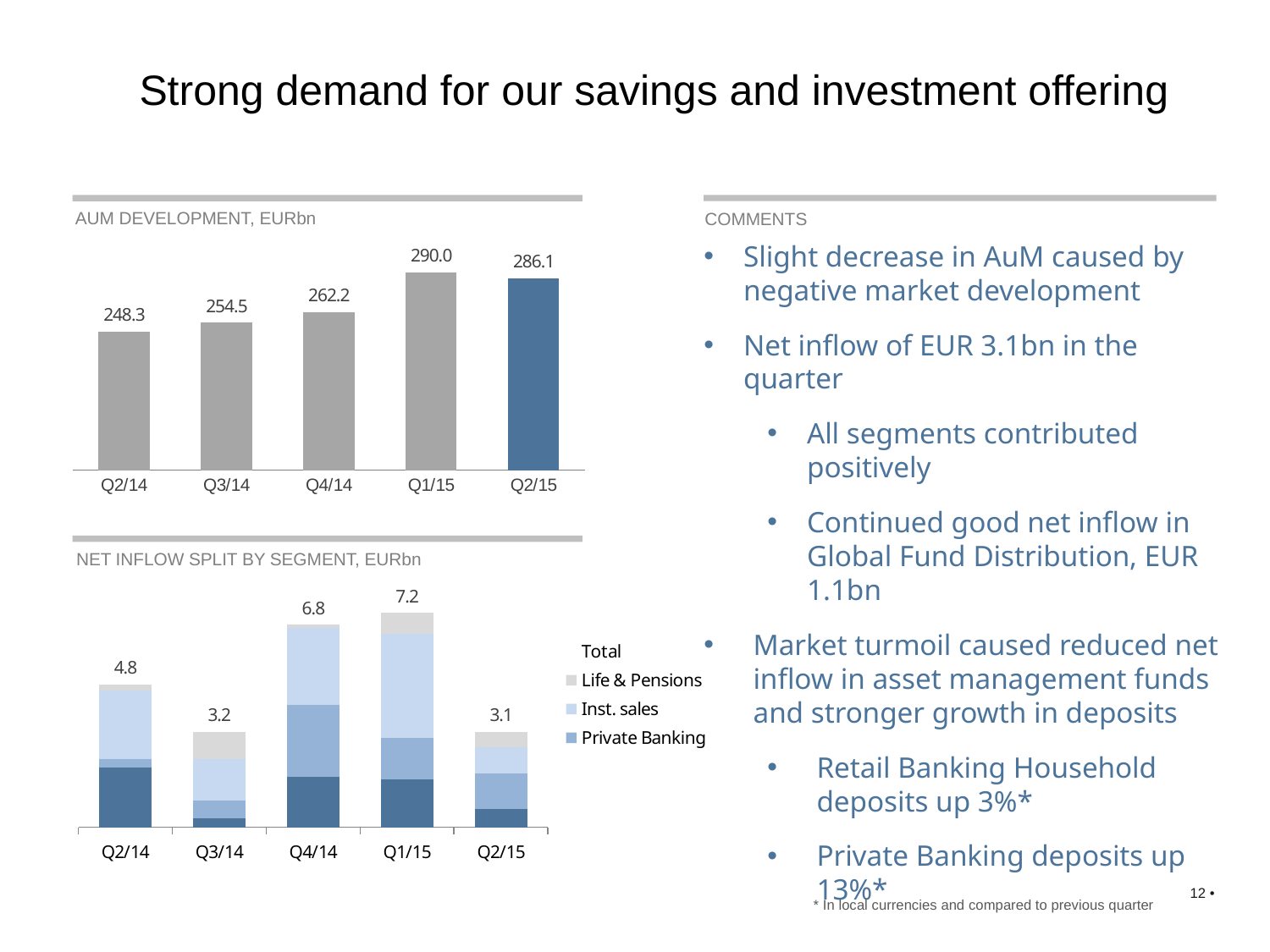
In the NET INFLOW SPLIT BY SEGMENT chart, what is the total net inflow for Q4/14? 6.8 In the AUM DEVELOPMENT chart, how many quarters are shown? 5 In the AUM DEVELOPMENT chart, which quarter has the highest AuM? Q1/15 In the NET INFLOW SPLIT BY SEGMENT chart, is the total for Q2/14 or Q3/14 larger? Q2/14 In the NET INFLOW SPLIT BY SEGMENT chart, which quarter has the highest total net inflow? Q1/15 What type of chart is the AUM DEVELOPMENT chart? Bar chart In the AUM DEVELOPMENT chart, which quarter has the lowest AuM? Q2/14 In the AUM DEVELOPMENT chart, what is the AuM value for Q2/14? 248.3 In the AUM DEVELOPMENT chart, what is the AuM value for Q1/15? 290.0 In the NET INFLOW SPLIT BY SEGMENT chart, which quarter has the lowest total net inflow? Q2/15 In the NET INFLOW SPLIT BY SEGMENT chart, which segments are listed in the legend besides Total? Life & Pensions, Inst. sales, Private Banking In the AUM DEVELOPMENT chart, what is the difference between the Q1/15 and Q2/15 values? 3.9